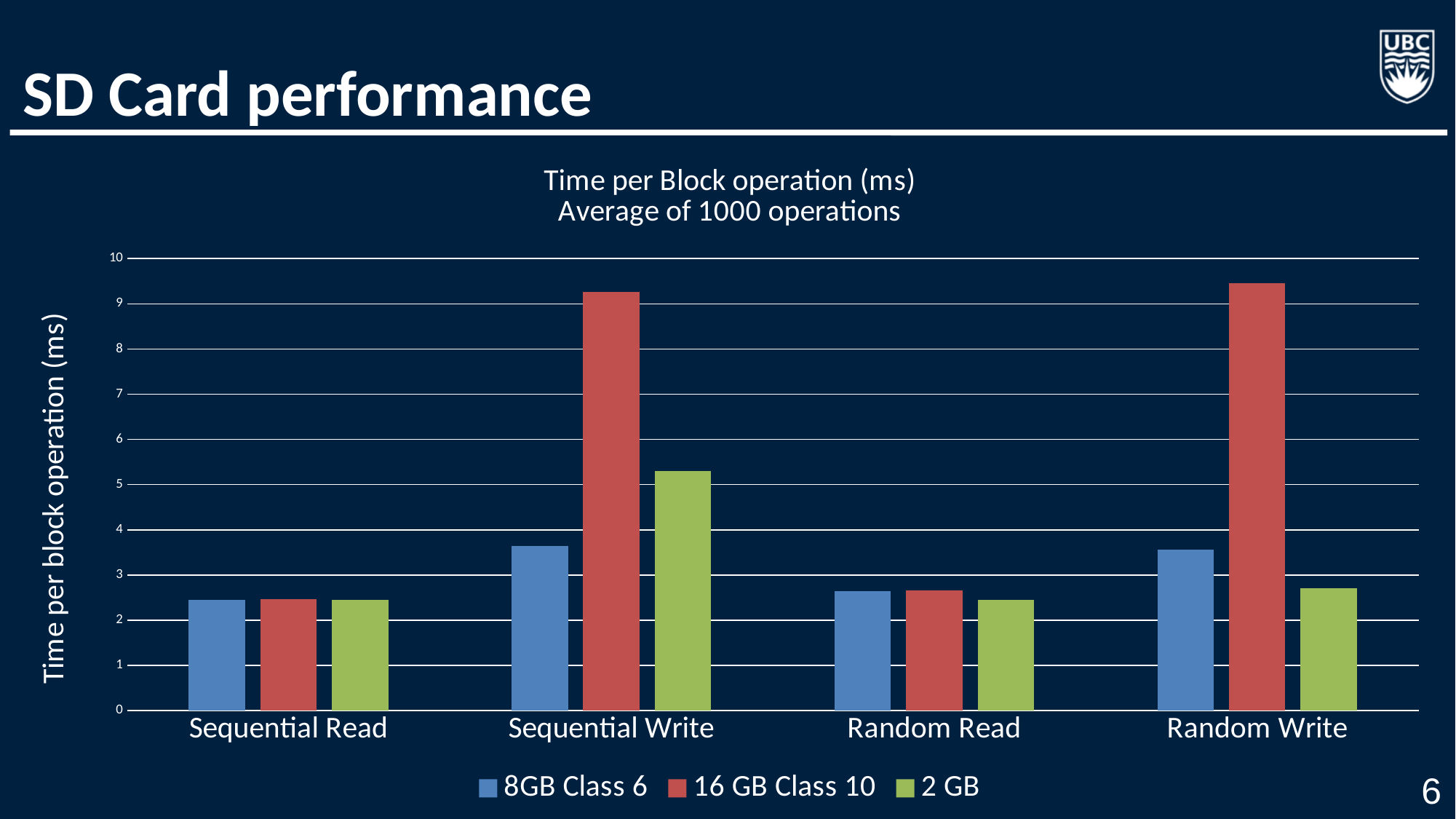
How many operation categories are shown on the x axis? 4 For Sequential Write, which is larger: the 2 GB value or the 8GB Class 6 value? 2 GB For Sequential Write, which series has the highest time per block operation? 16 GB Class 10 For Random Write, which is larger: the 16 GB Class 10 value or the 2 GB value? 16 GB Class 10 What kind of chart is shown on the slide? bar chart Is the value for 2 GB at Sequential Write greater or less than 4? greater Is the value for 8GB Class 6 at Sequential Read greater or less than 3? less How many series does the legend list? 3 What is the label of the y axis? Time per block operation (ms) Is the value for 8GB Class 6 at Random Write greater or less than 4? less For Random Write, which series has the lowest time per block operation? 2 GB